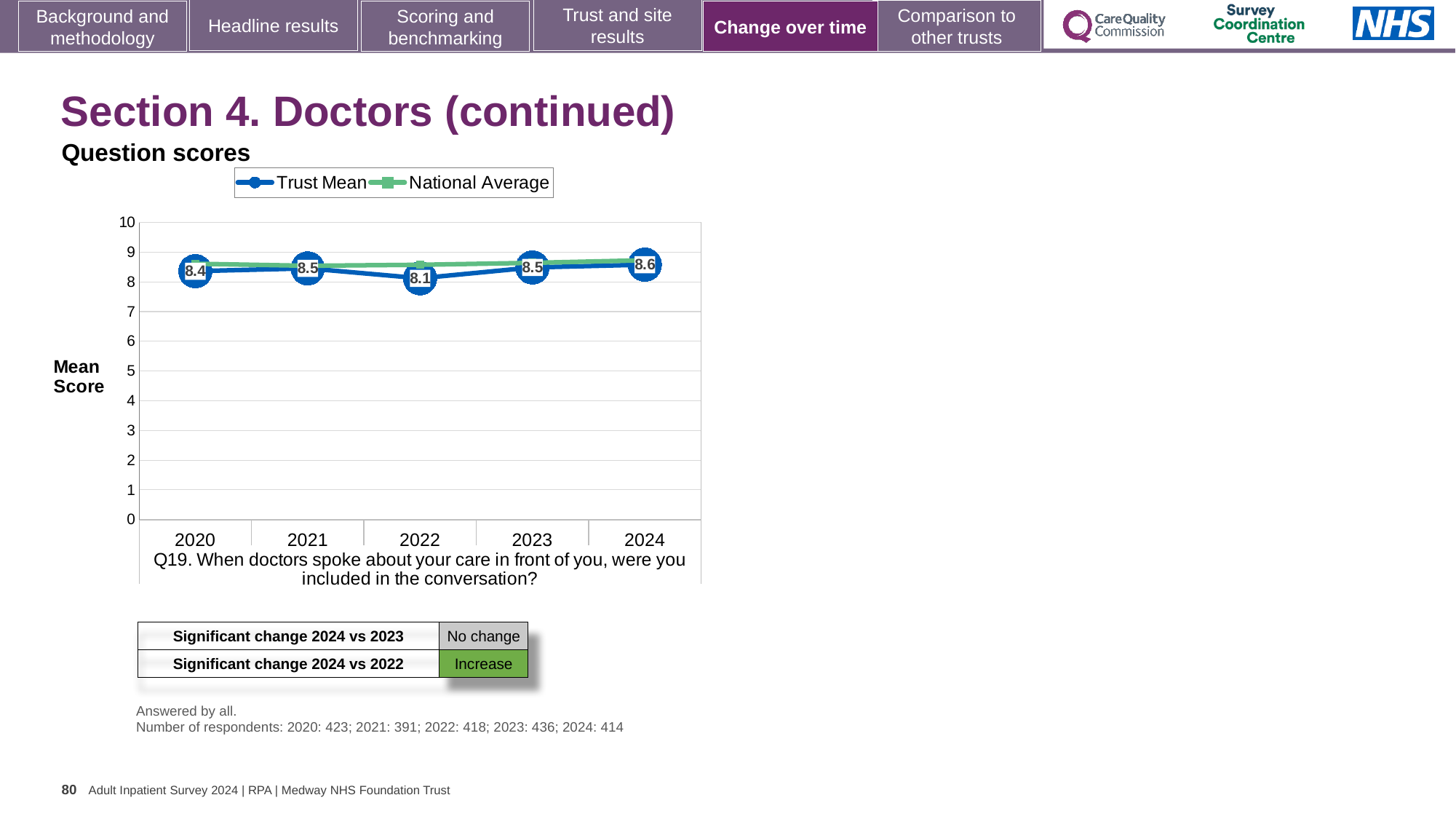
What is the Trust Mean score for 2022? 8.1 Is the Trust Mean score for 2022 greater or less than 9? less What kind of chart is shown? line chart What is the Trust Mean score for 2024? 8.6 How many series does the legend list? 2 Is the Trust Mean score for 2021 greater or less than the Trust Mean score for 2022? greater In which year is the Trust Mean score highest? 2024 What is the Trust Mean score for 2020? 8.4 How many years are plotted on the x axis? 5 What is the difference between the Trust Mean scores for 2024 and 2022? 0.5 What is the label of the y axis? Mean Score In which year is the Trust Mean score lowest? 2022